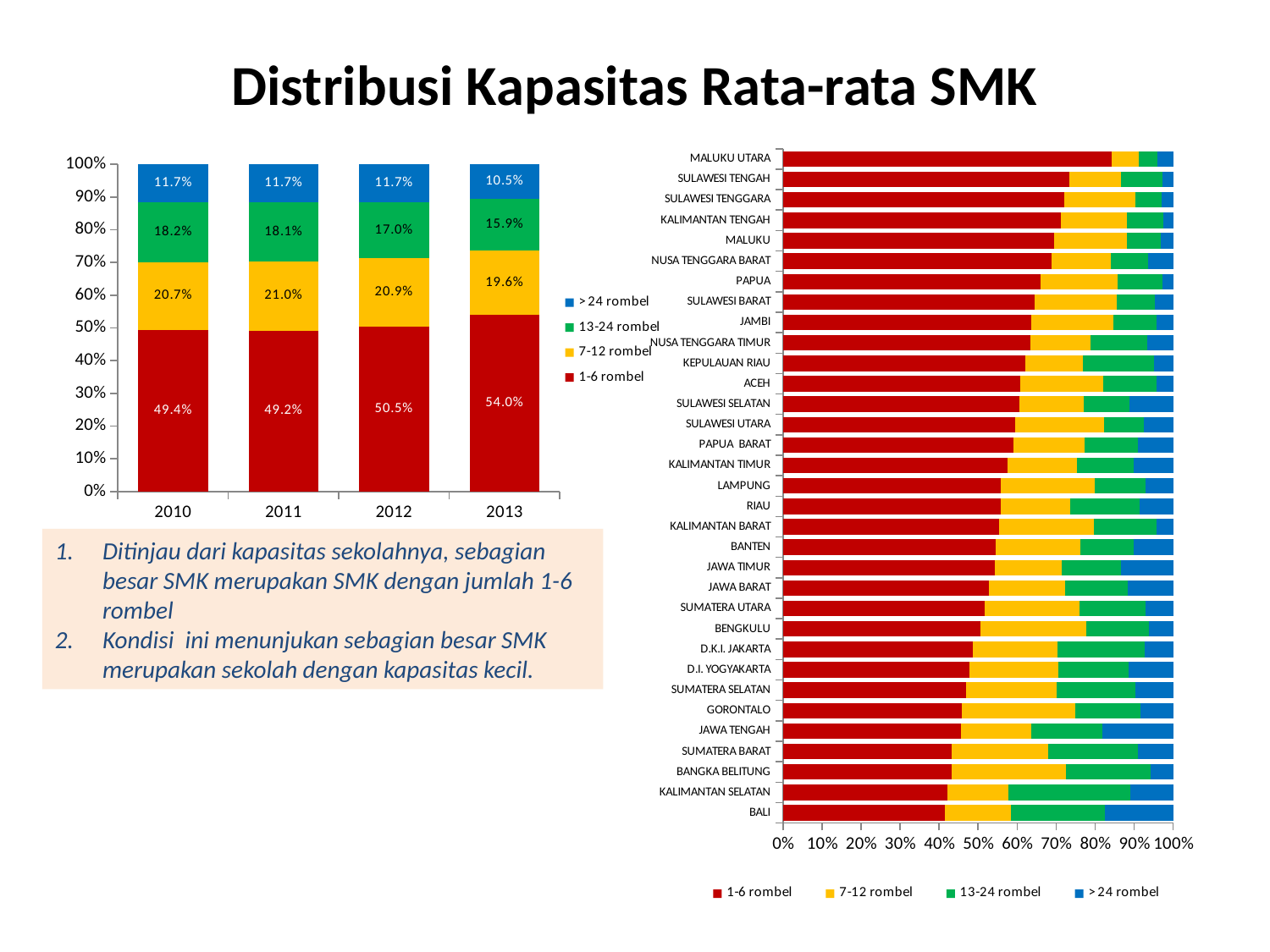
In the left chart (by year), how many series does the legend list? 4 In the left chart (by year), which year has the highest share of 1-6 rombel? 2013 In the left chart (by year), what is the value for 7-12 rombel in 2011? 21.0% In the left chart (by year), which year has the lowest share of 13-24 rombel? 2013 In the left chart (by year), what is the value for > 24 rombel in 2013? 10.5% In the right chart (by province), which province has the largest 1-6 rombel share? MALUKU UTARA What kind of chart is the right chart (by province)? Stacked bar chart In the left chart (by year), is the 13-24 rombel share larger in 2010 or in 2013? 2010 In the left chart (by year), how many years are shown on the x axis? 4 In the right chart (by province), is the 1-6 rombel share for BALI greater or less than 50%? less In the left chart (by year), what is the difference between the 1-6 rombel share in 2013 and in 2012? 3.5% In the left chart (by year), what is the value for 1-6 rombel in 2013? 54.0%